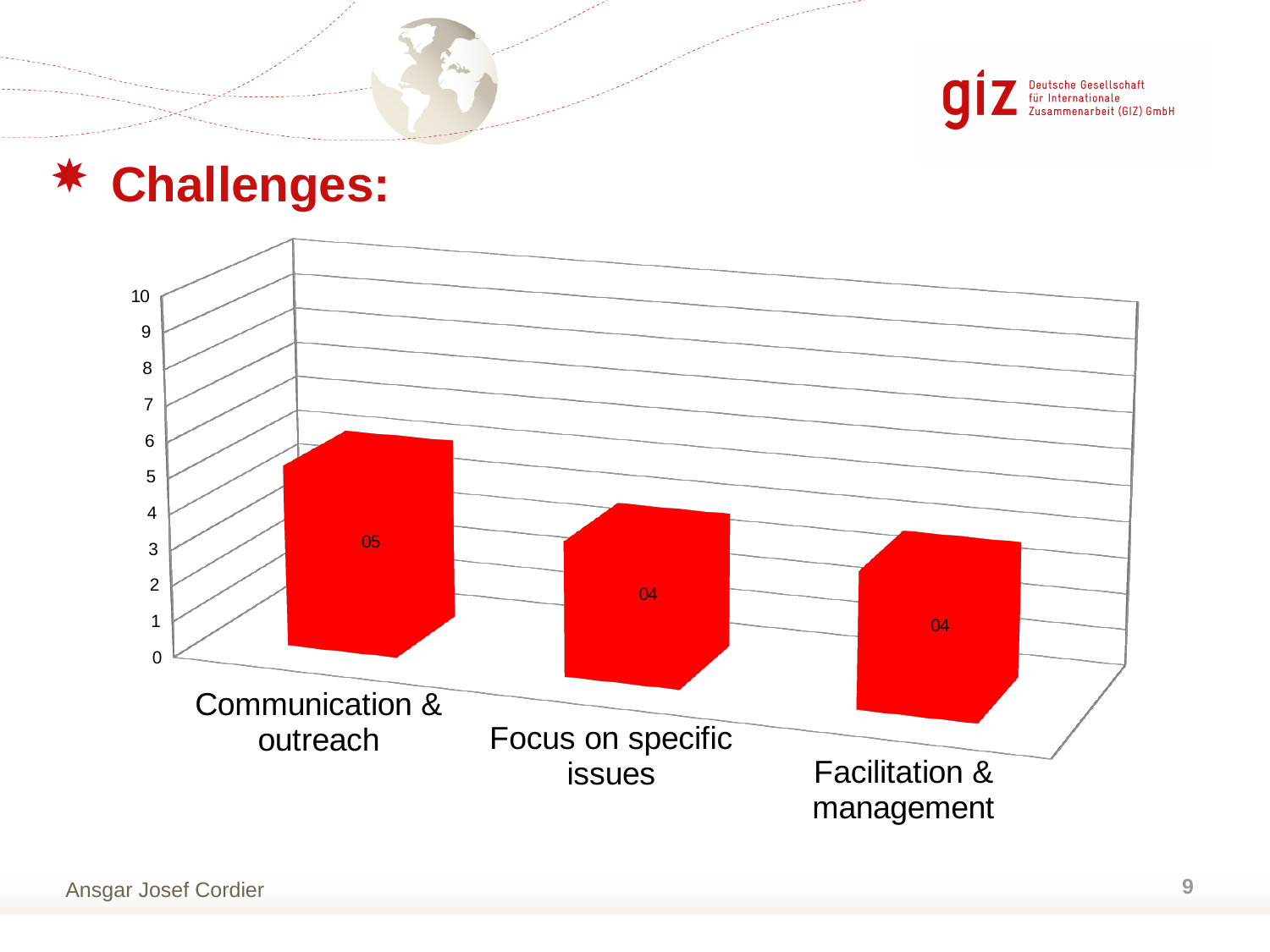
Is the value for Communication & outreach greater or less than 10? less What is the value for Facilitation & management? 04 What is the difference between the values for Communication & outreach and Focus on specific issues? 1 Which is larger, the value for Communication & outreach or the value for Facilitation & management? Communication & outreach Which category has the highest value? Communication & outreach How many categories are shown in the chart? 3 What colour are the bars in the chart? red What is the value for Focus on specific issues? 04 What is the value for Communication & outreach? 05 What kind of chart is shown on the slide? bar chart Do the values rise or fall from Communication & outreach to Focus on specific issues? fall What is the highest value shown on the vertical axis? 10